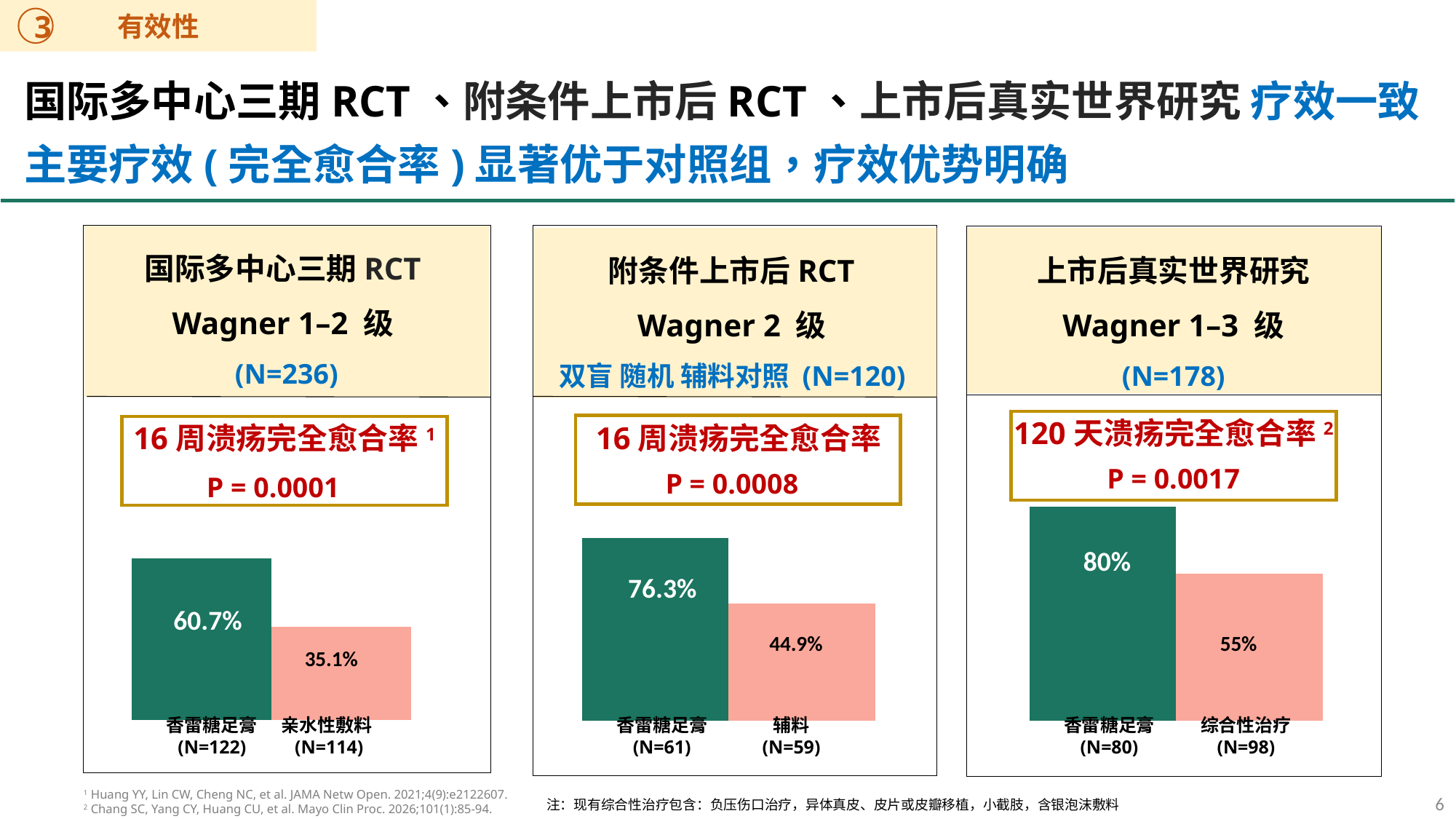
Is the healing rate for 香雷糖足膏 in the left chart larger or smaller than the healing rate for 香雷糖足膏 in the right chart? smaller In the left chart (国际多中心三期 RCT), what is the 16-week complete healing rate for 香雷糖足膏? 60.7% In the right chart (上市后真实世界研究), which group has the lower healing rate? 综合性治疗 In the left chart (国际多中心三期 RCT), what is the value for 亲水性敷料? 35.1% In the middle chart (附条件上市后 RCT), which group has the higher healing rate? 香雷糖足膏 What type of chart is used in the right panel (上市后真实世界研究)? bar chart How many bars are shown in the middle chart (附条件上市后 RCT)? 2 In the right chart (上市后真实世界研究), what is the difference between 香雷糖足膏 and 综合性治疗? 25% In the right chart (上市后真实世界研究), what is the 120-day complete healing rate for 综合性治疗? 55% In the middle chart (附条件上市后 RCT), what is the value for 辅料? 44.9% In the middle chart (附条件上市后 RCT), how much higher is the healing rate for 香雷糖足膏 than for 辅料? 31.4% In the left chart (国际多中心三期 RCT), what is the difference between the healing rates of 香雷糖足膏 and 亲水性敷料? 25.6%